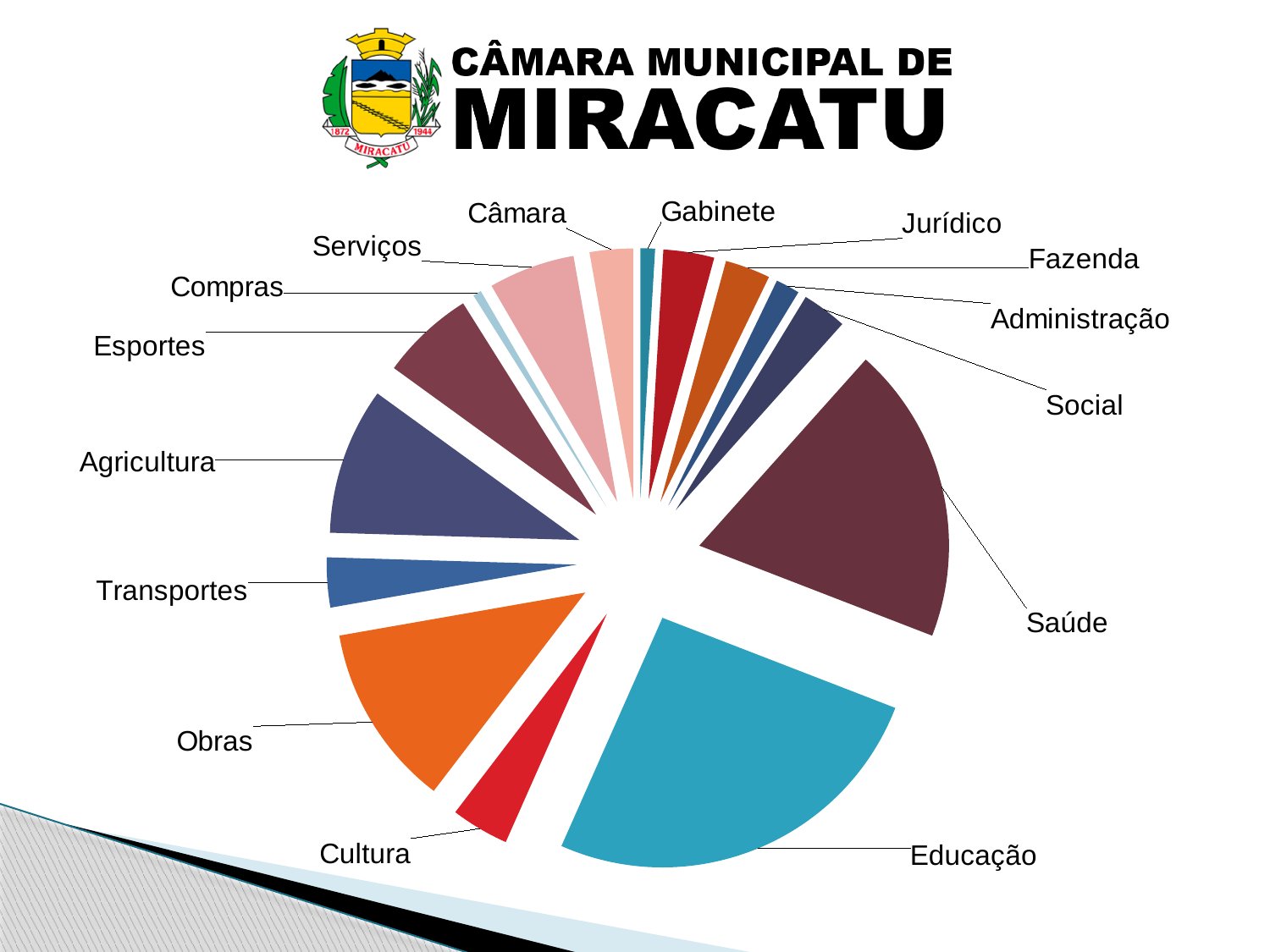
Which category has the largest slice of the pie chart? Educação Which slice is larger, Obras or Transportes? Obras Which slice is larger, Saúde or Obras? Saúde How many categories (slices) does the pie chart have? 15 What kind of chart is shown on the slide? pie chart Which slice is larger, Esportes or Gabinete? Esportes What colour is the Educação slice? teal (light blue) Which category has the second-largest slice of the pie chart? Saúde Are the slices of the pie chart separated (exploded) from each other? yes